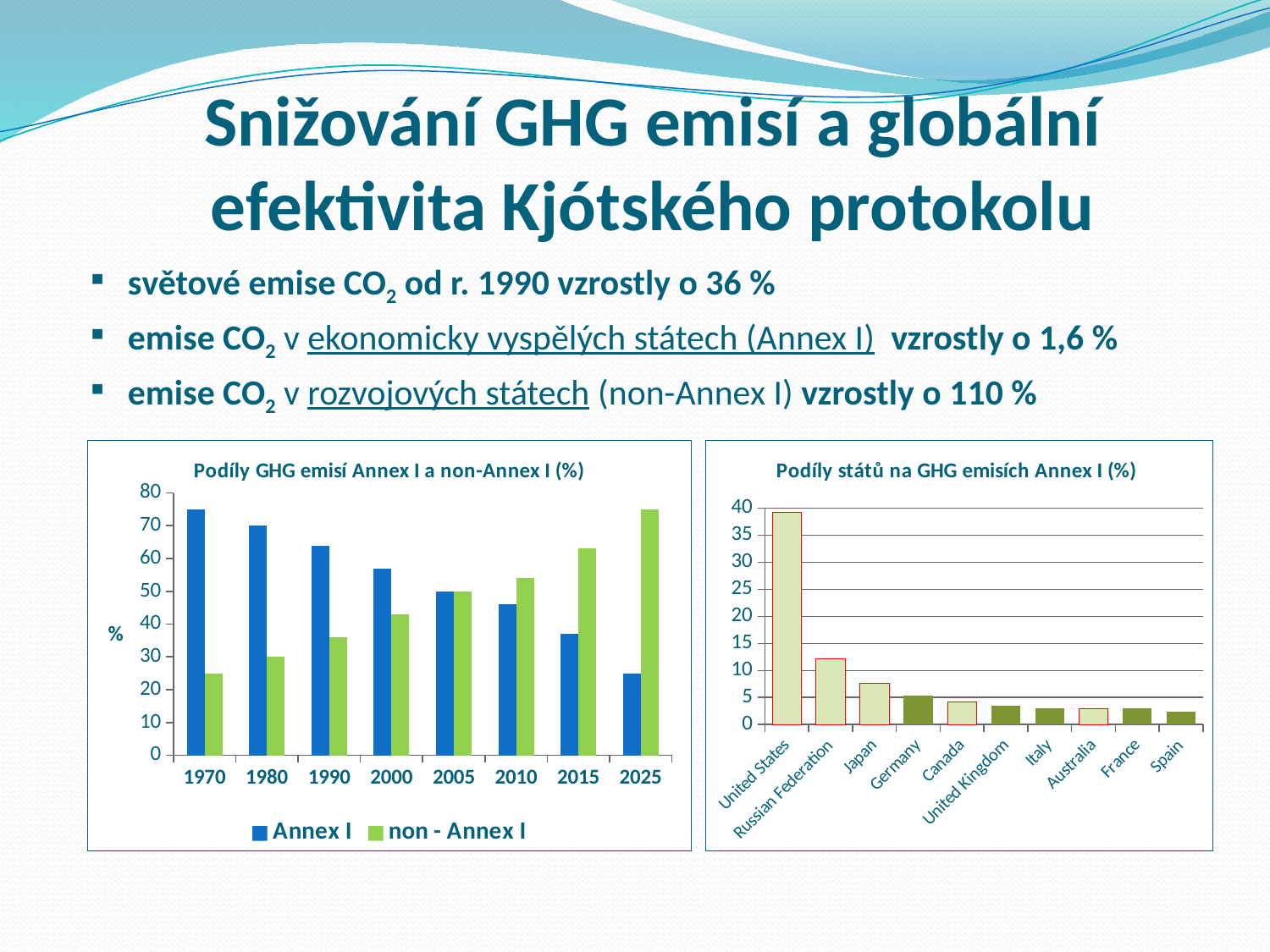
In the left chart 'Podíly GHG emisí Annex I a non-Annex I (%)', does the Annex I series rise or fall from 1970 to 2025? fall What kind of chart is the left chart, 'Podíly GHG emisí Annex I a non-Annex I (%)'? bar chart How many series does the legend of the left chart 'Podíly GHG emisí Annex I a non-Annex I (%)' list? 2 In the left chart 'Podíly GHG emisí Annex I a non-Annex I (%)', is the Annex I value for 1970 greater or less than 70? greater In the right chart 'Podíly států na GHG emisích Annex I (%)', which country has the highest share? United States How many countries are shown in the right chart 'Podíly států na GHG emisích Annex I (%)'? 10 In the left chart 'Podíly GHG emisí Annex I a non-Annex I (%)', which series is larger in 2015, Annex I or non-Annex I? non - Annex I What are the two legend entries of the left chart 'Podíly GHG emisí Annex I a non-Annex I (%)'? Annex I and non - Annex I How many years are shown on the x axis of the left chart 'Podíly GHG emisí Annex I a non-Annex I (%)'? 8 In the right chart 'Podíly států na GHG emisích Annex I (%)', which country has the lowest share? Spain In the left chart 'Podíly GHG emisí Annex I a non-Annex I (%)', what is the Annex I value for 2005? 50 In the right chart 'Podíly států na GHG emisích Annex I (%)', is the value for the Russian Federation greater or less than 15? less